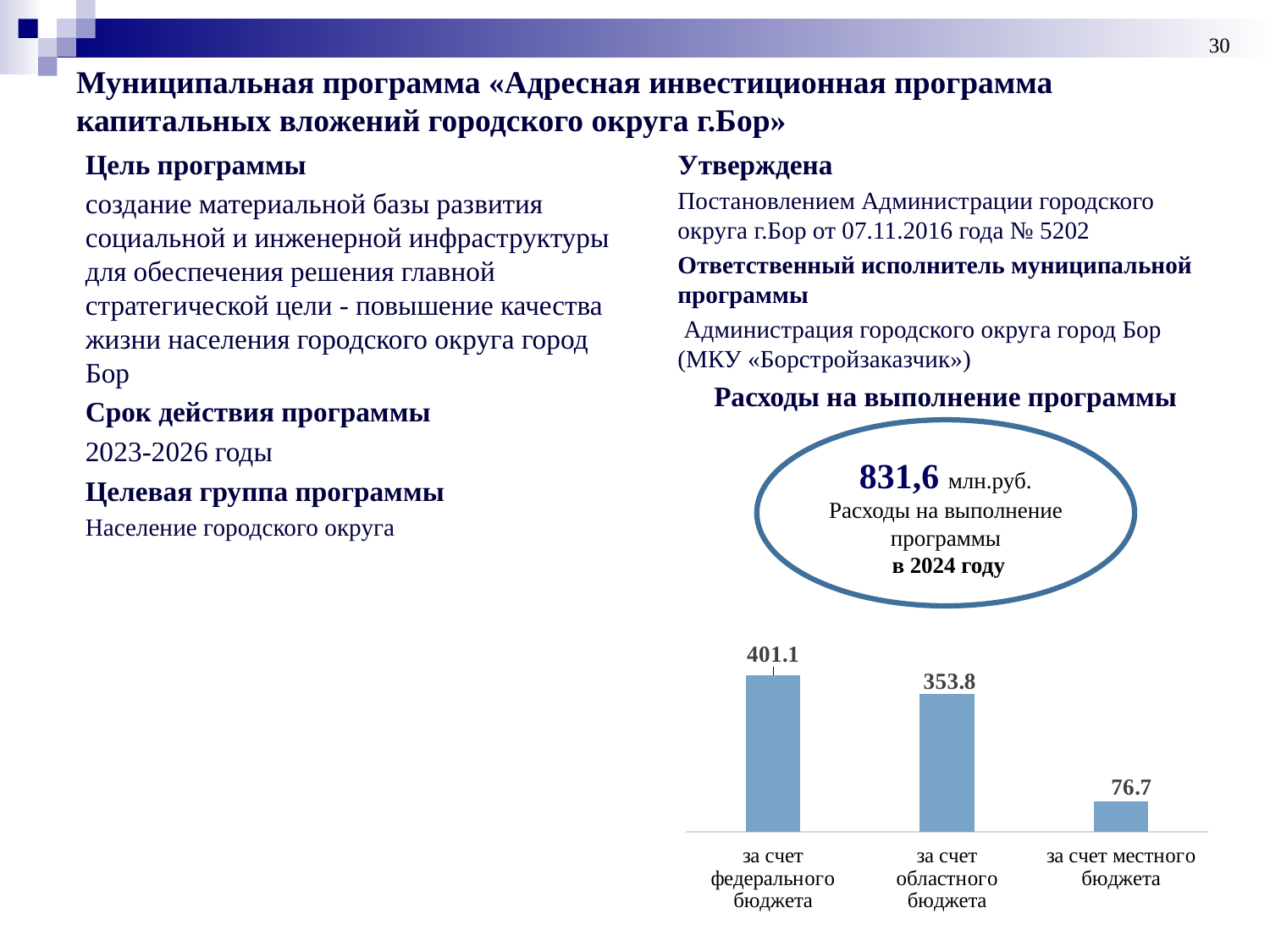
What is the value for 'за счет федерального бюджета' in the chart? 401.1 Which category has the highest value in the chart? за счет федерального бюджета What is the value for 'за счет местного бюджета' in the chart? 76.7 Which category has the lowest value in the chart? за счет местного бюджета Do the values rise or fall from left to right across the categories in the chart? fall Which is larger: the value for 'за счет областного бюджета' or 'за счет местного бюджета'? за счет областного бюджета How many categories are shown in the chart? 3 What is the title of the chart on the slide? Расходы на выполнение программы What kind of chart is shown on the slide? bar chart What is the difference between the values for 'за счет областного бюджета' and 'за счет местного бюджета'? 277.1 What is the value for 'за счет областного бюджета' in the chart? 353.8 What is the difference between the values for 'за счет федерального бюджета' and 'за счет областного бюджета'? 47.3